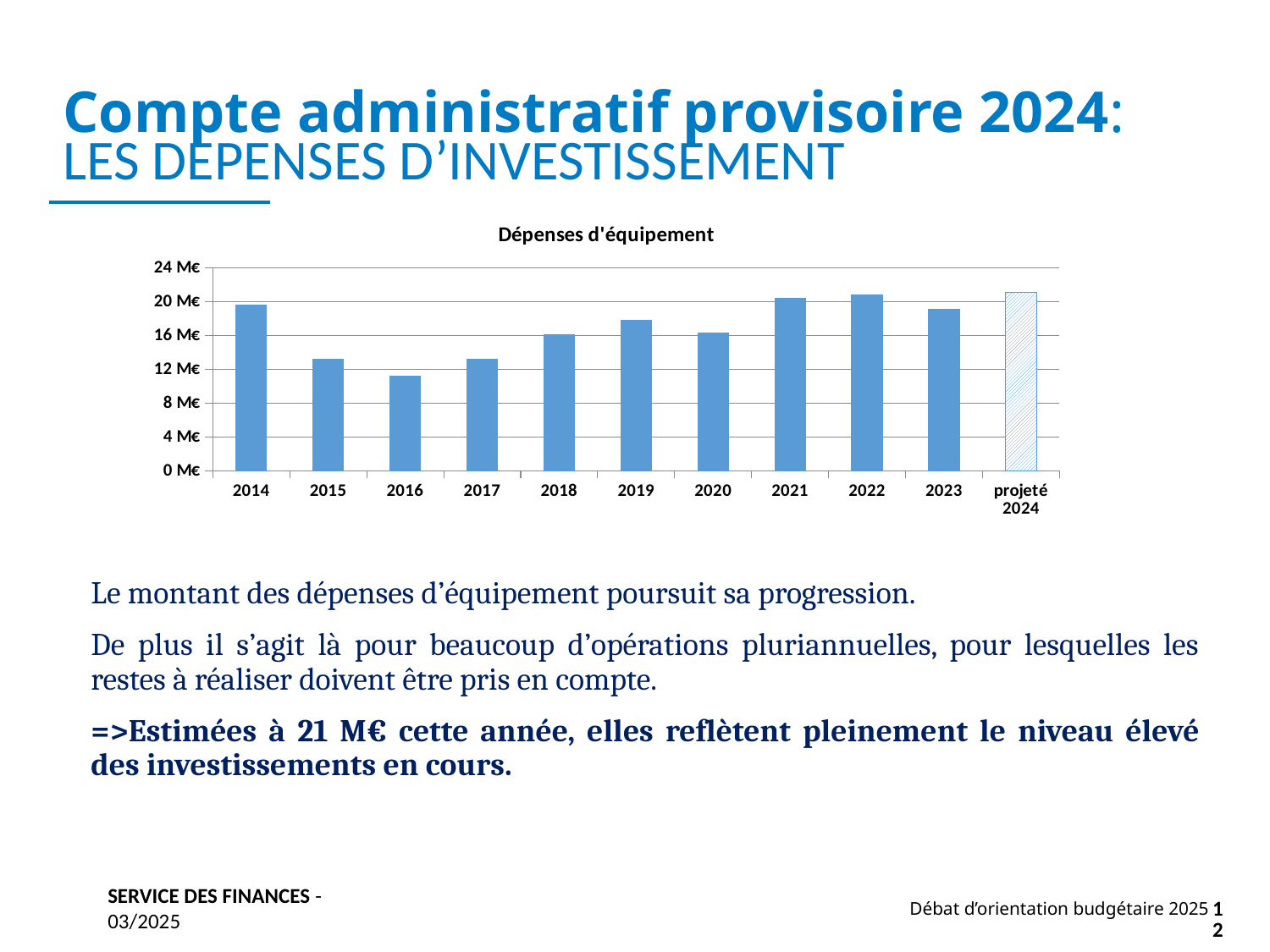
Is the value for 2023 greater or less than 20 M€? less Do the values rise or fall from 2014 to 2016? fall Which is larger, the value for 2017 or the value for 2019? 2019 Which is larger, the value for 2014 or the value for 2015? 2014 What kind of chart is shown on the slide? bar chart Which bar is drawn with a hatched pattern instead of a solid fill? projeté 2024 What is the title of the chart? Dépenses d'équipement Which year has the lowest value in the chart? 2016 Is the value for 2015 greater or less than 12 M€? greater Is the value for 2016 greater or less than 12 M€? less How many bars (categories) are plotted in the chart? 11